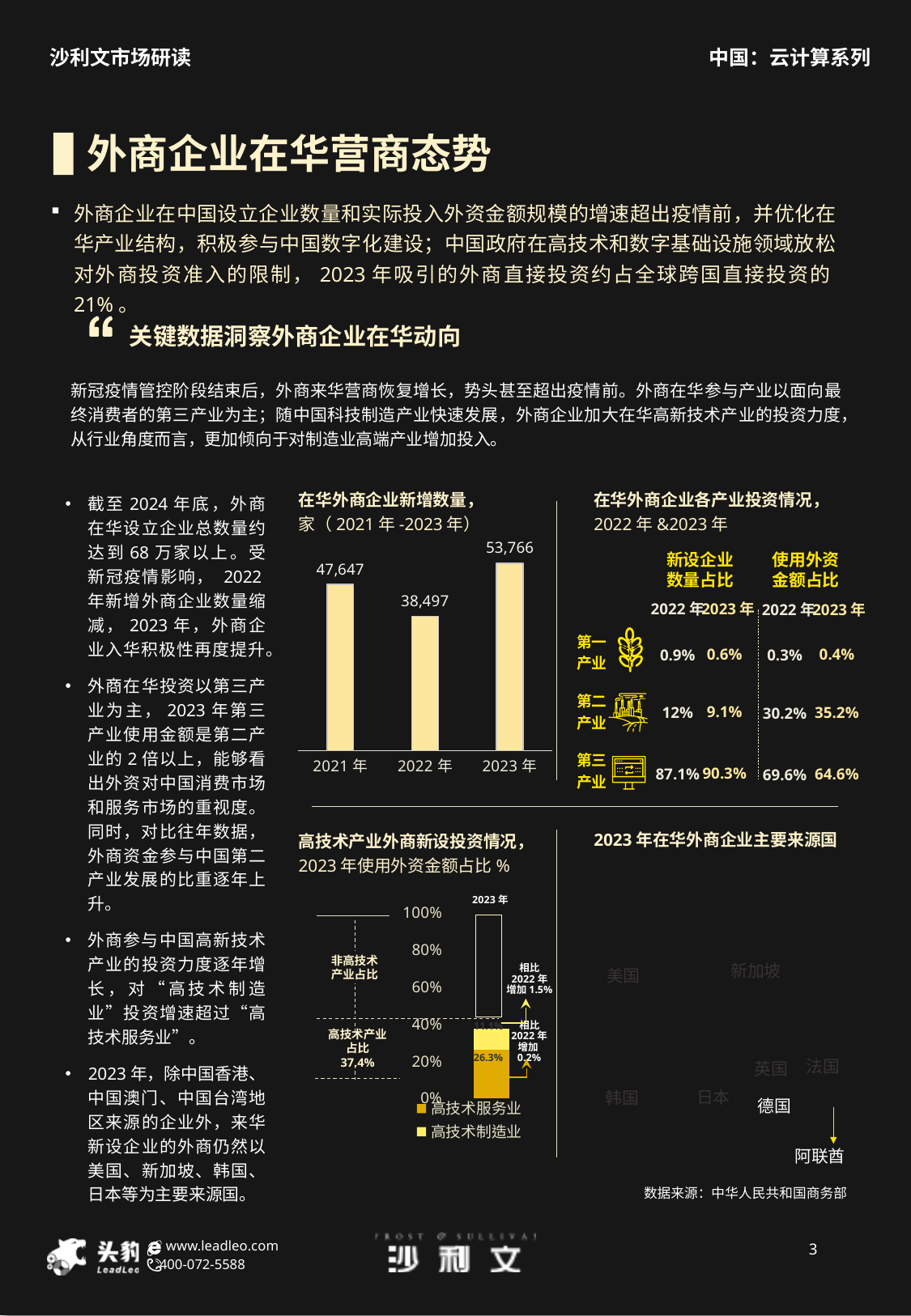
In the chart titled 在华外商企业新增数量, what is the value for 2021年? 47,647 In the chart titled 在华外商企业各产业投资情况, what is the 新设企业数量占比 for 第三产业 in 2023年? 90.3% In the chart titled 在华外商企业各产业投资情况, which is larger: the 使用外资金额占比 for 第三产业 in 2022年 or in 2023年? 2022年 In the chart titled 在华外商企业新增数量, which year has the lowest value? 2022年 In the chart titled 在华外商企业新增数量, what is the difference between the 2023年 and 2022年 values? 15,269 In the chart titled 在华外商企业新增数量, what is the value for 2023年? 53,766 In the chart titled 在华外商企业各产业投资情况, what is the 使用外资金额占比 for 第二产业 in 2023年? 35.2% In the chart titled 在华外商企业新增数量, which year has the highest value? 2023年 What kind of chart is the one titled 在华外商企业新增数量? bar chart In the chart titled 高技术产业外商新设投资情况, what is the value for 高技术制造业? 26.3% In the chart titled 在华外商企业新增数量, how many years are plotted? 3 In the chart titled 高技术产业外商新设投资情况, how many series does the legend list? 2